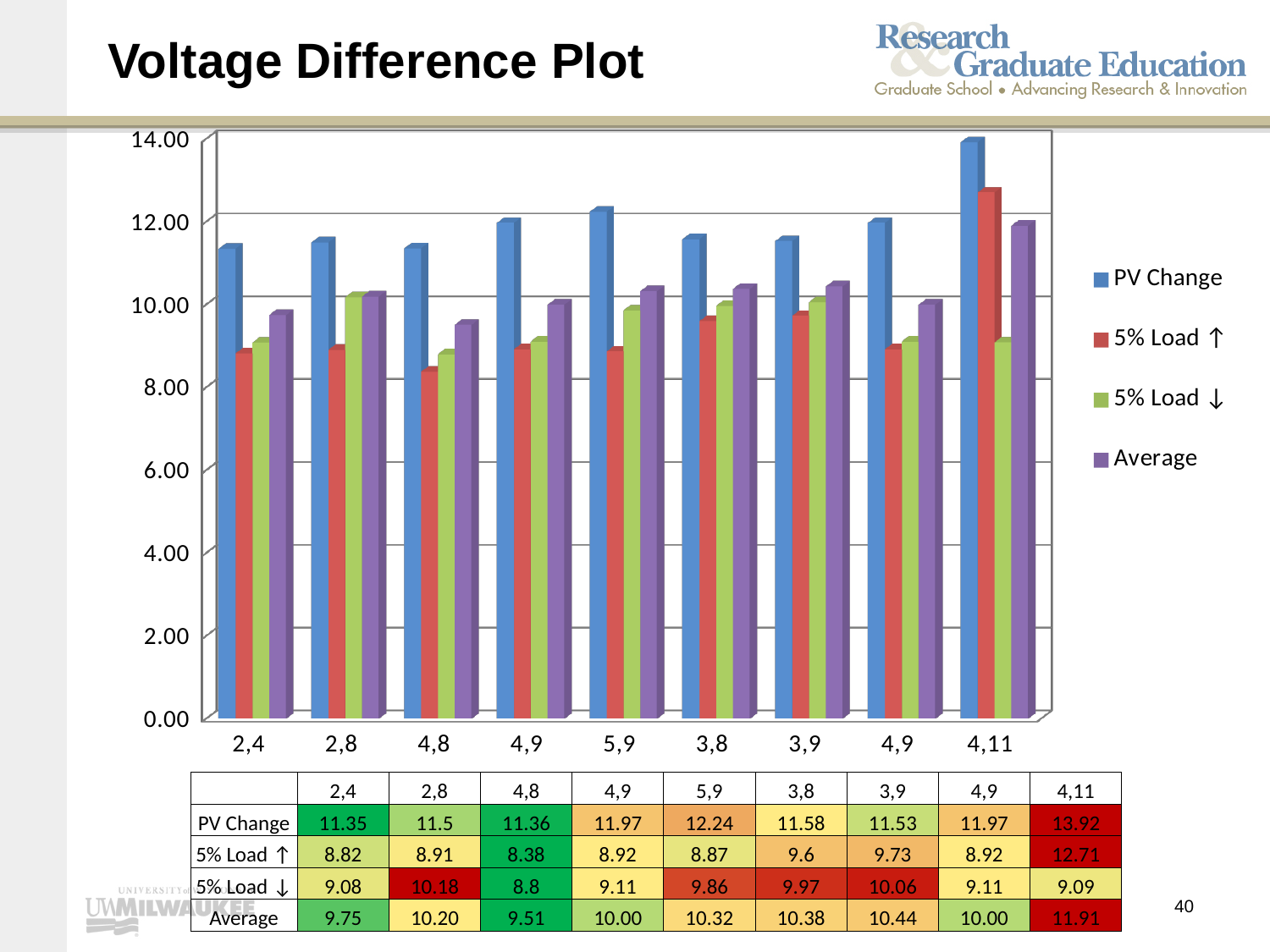
Which category has the highest PV Change value? 4,11 Which category has the larger 5% Load ↓ value, 3,8 or 3,9? 3,9 What kind of chart is shown on the slide? bar chart What is the PV Change value for category 4,11? 13.92 What is the 5% Load ↓ value for category 2,8? 10.18 What is the Average value for category 3,9? 10.44 Is the PV Change value for category 5,9 greater or less than 12.00? greater For category 4,11, what is the difference between the PV Change value and the 5% Load ↑ value? 1.21 What is the 5% Load ↑ value for category 2,4? 8.82 How many categories are shown on the x axis of the chart? 9 How many series does the legend list? 4 Which category has the lowest 5% Load ↑ value? 4,8